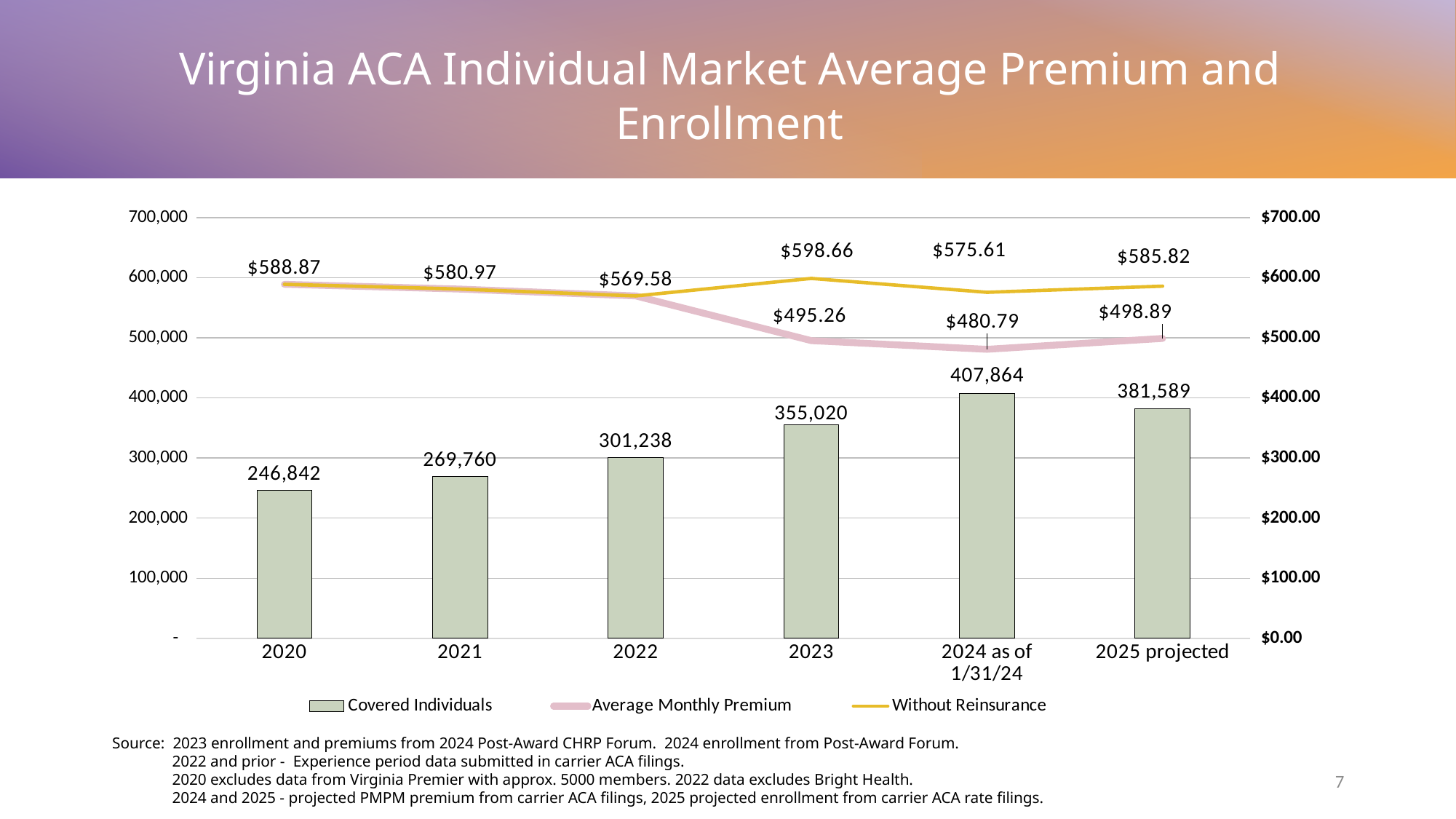
Which year has more Covered Individuals, 2022 or 2023? 2023 What is the Without Reinsurance value for 2023? $598.66 In which year is the Average Monthly Premium lowest? 2024 as of 1/31/24 What is the Average Monthly Premium for 2025 projected? $498.89 How many series does the legend list? 3 What is the difference in Covered Individuals between 2024 as of 1/31/24 and 2025 projected? 26,275 For 2025 projected, how much higher is the Without Reinsurance value than the Average Monthly Premium? $86.93 Which year has the highest number of Covered Individuals? 2024 as of 1/31/24 What is the Average Monthly Premium for 2024 as of 1/31/24? $480.79 Do the Covered Individuals rise or fall from 2020 to 2024 as of 1/31/24? rise Which year has the lowest number of Covered Individuals? 2020 How many Covered Individuals are shown for 2023? 355,020